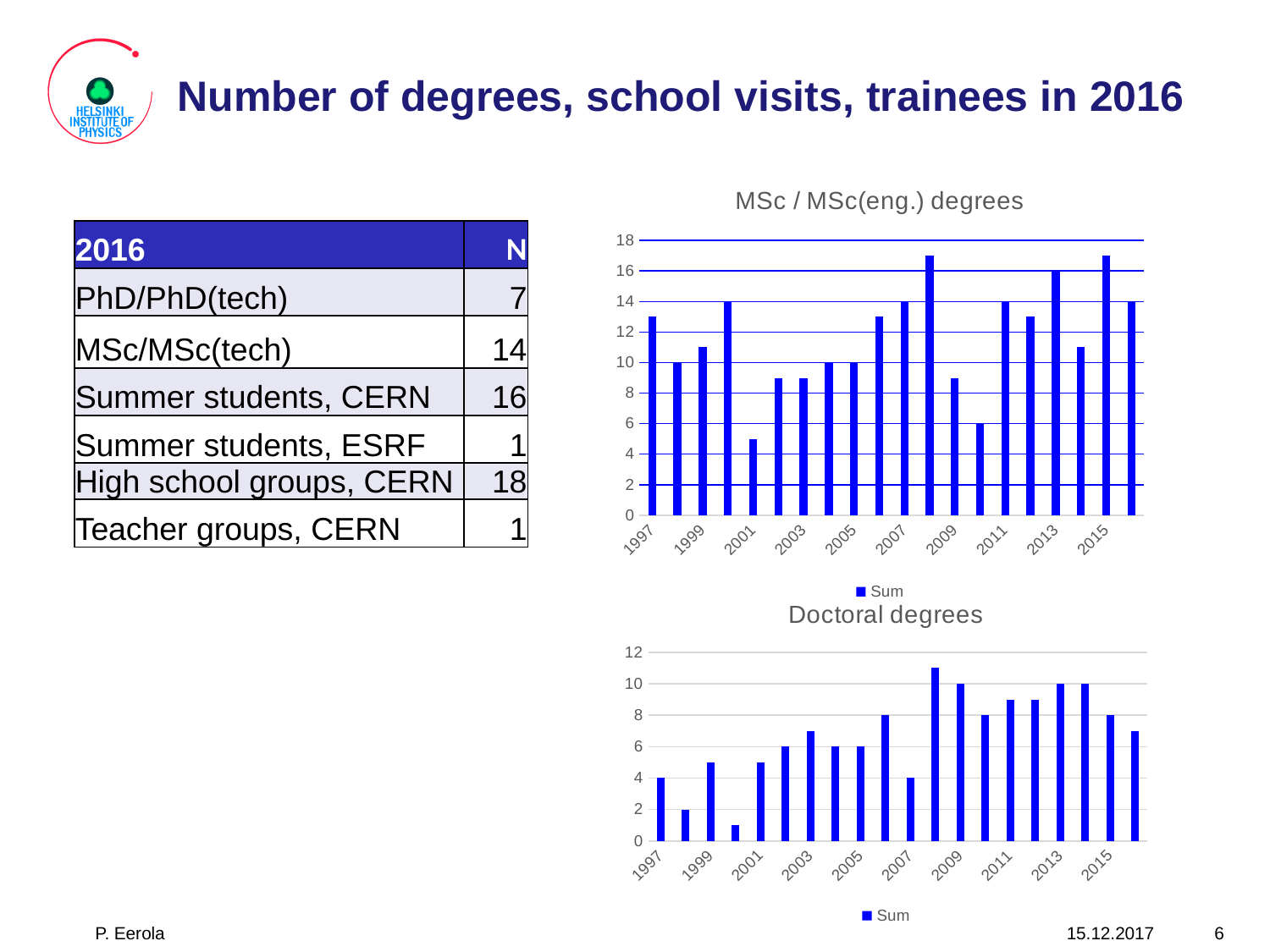
What type of chart is the "MSc / MSc(eng.) degrees" chart? bar chart In the "Doctoral degrees" chart, which is larger, the value for 2009 or the value for 1997? 2009 In the "MSc / MSc(eng.) degrees" chart, is the value for 2001 greater or less than 8? less In the "MSc / MSc(eng.) degrees" chart, what is the value for 2005? 10 In the "Doctoral degrees" chart, which year has the highest value? 2008 In the "MSc / MSc(eng.) degrees" chart, which year has the lowest value? 2001 In the "Doctoral degrees" chart, is the value for 2011 greater or less than 6? greater In the "Doctoral degrees" chart, what is the value for 2009? 10 In the "MSc / MSc(eng.) degrees" chart, what is the difference between the values for 2013 and 2005? 6 In the "Doctoral degrees" chart, do the values rise or fall from 2013 to 2016? fall How many series does the legend of the "Doctoral degrees" chart list? 1 In the "MSc / MSc(eng.) degrees" chart, what is the value for 2013? 16